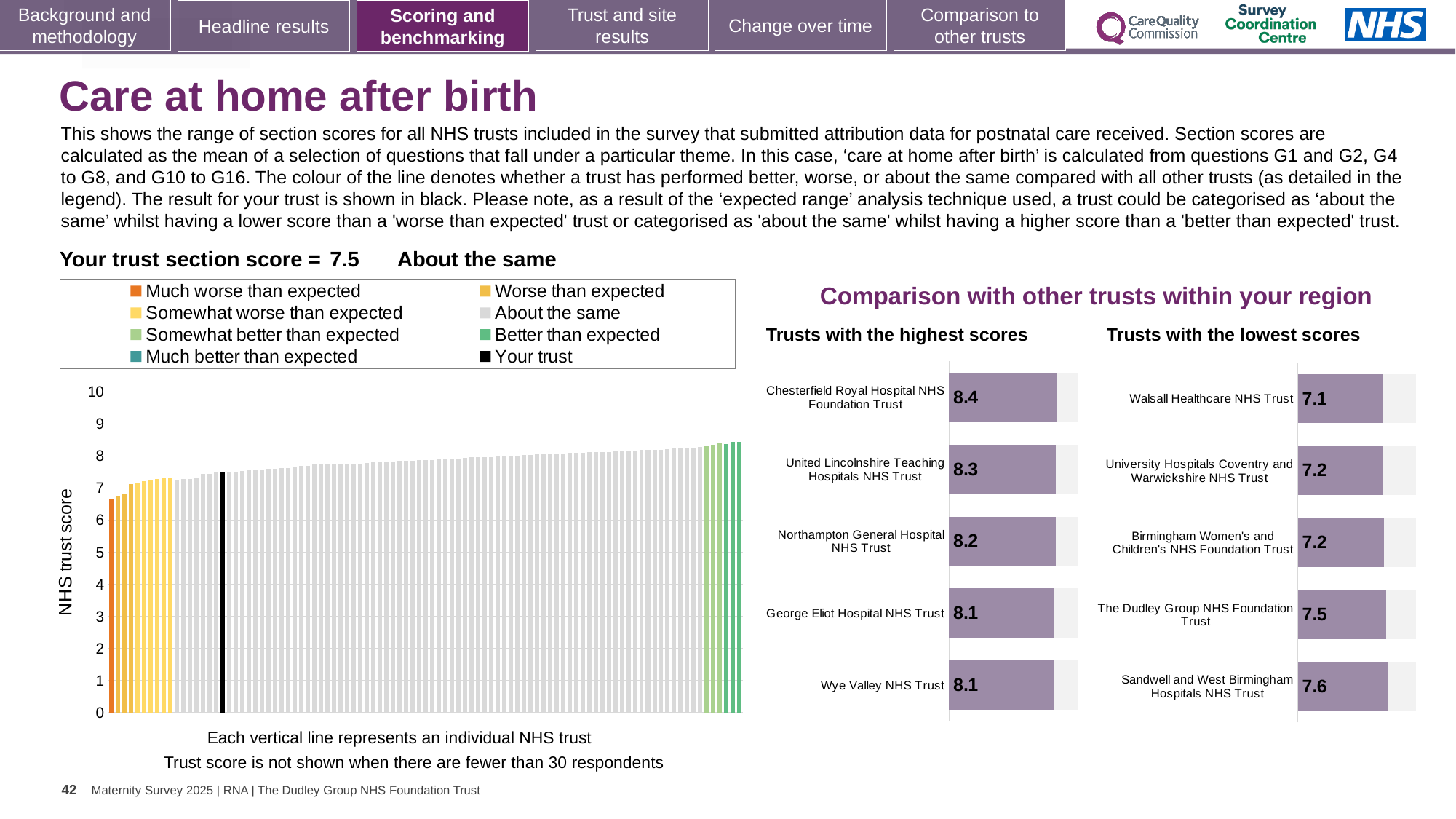
In the 'Trusts with the lowest scores' chart, what is the score for Sandwell and West Birmingham Hospitals NHS Trust? 7.6 In the large chart on the left, is the value for the black bar (your trust) greater or less than 7? greater In the 'Trusts with the highest scores' chart, what is the score for Northampton General Hospital NHS Trust? 8.2 In the 'Trusts with the highest scores' chart, what is the score for Chesterfield Royal Hospital NHS Foundation Trust? 8.4 How many trusts are shown in the 'Trusts with the lowest scores' chart? 5 In the 'Trusts with the highest scores' chart, what is the difference between the scores of Chesterfield Royal Hospital NHS Foundation Trust and Wye Valley NHS Trust? 0.3 What kind of chart is the large chart on the left showing NHS trust scores? bar chart In the large chart on the left, do the bar values rise or fall from left to right? rise In the 'Trusts with the lowest scores' chart, what is the score for Walsall Healthcare NHS Trust? 7.1 In the 'Trusts with the lowest scores' chart, which has the larger score: The Dudley Group NHS Foundation Trust or Walsall Healthcare NHS Trust? The Dudley Group NHS Foundation Trust In the 'Trusts with the lowest scores' chart, which trust has the lowest score? Walsall Healthcare NHS Trust In the 'Trusts with the highest scores' chart, which trust has the highest score? Chesterfield Royal Hospital NHS Foundation Trust